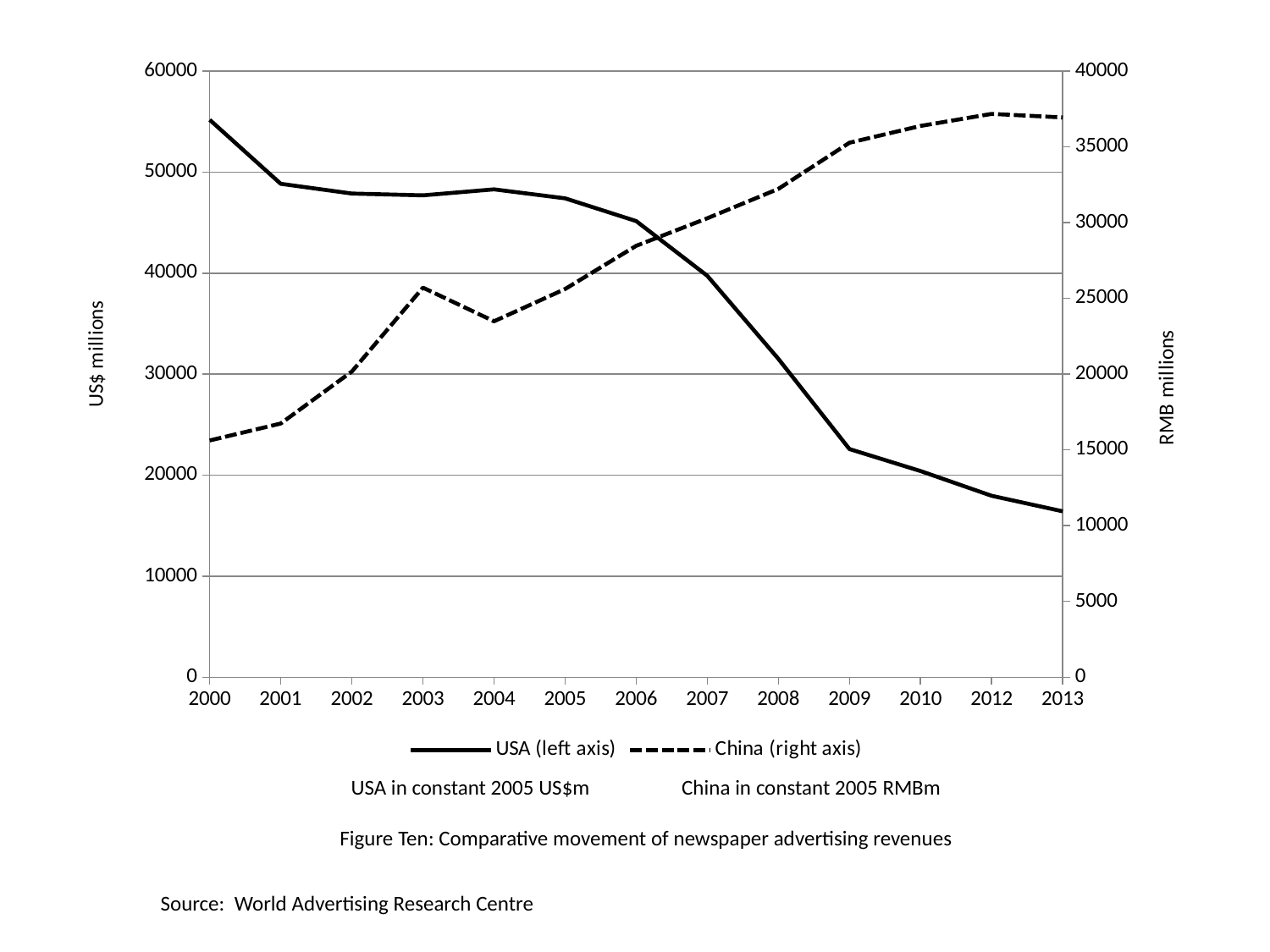
In which year is the USA (left axis) value lowest? 2013 What kind of chart is shown on the slide? line chart In which year is the China (right axis) value lowest? 2000 Is the USA (left axis) value for 2000 greater or less than 50000? greater How many years are plotted along the x axis? 13 Does the USA (left axis) series rise or fall from 2000 to 2013? fall How many series does the legend list? 2 Is the USA (left axis) value for 2009 greater or less than 30000? less Does the China (right axis) series rise or fall overall from 2000 to 2013? rise Is the China (right axis) value for 2000 greater or less than 20000? less What is the label of the right-hand vertical axis? RMB millions In which year is the USA (left axis) value highest? 2000